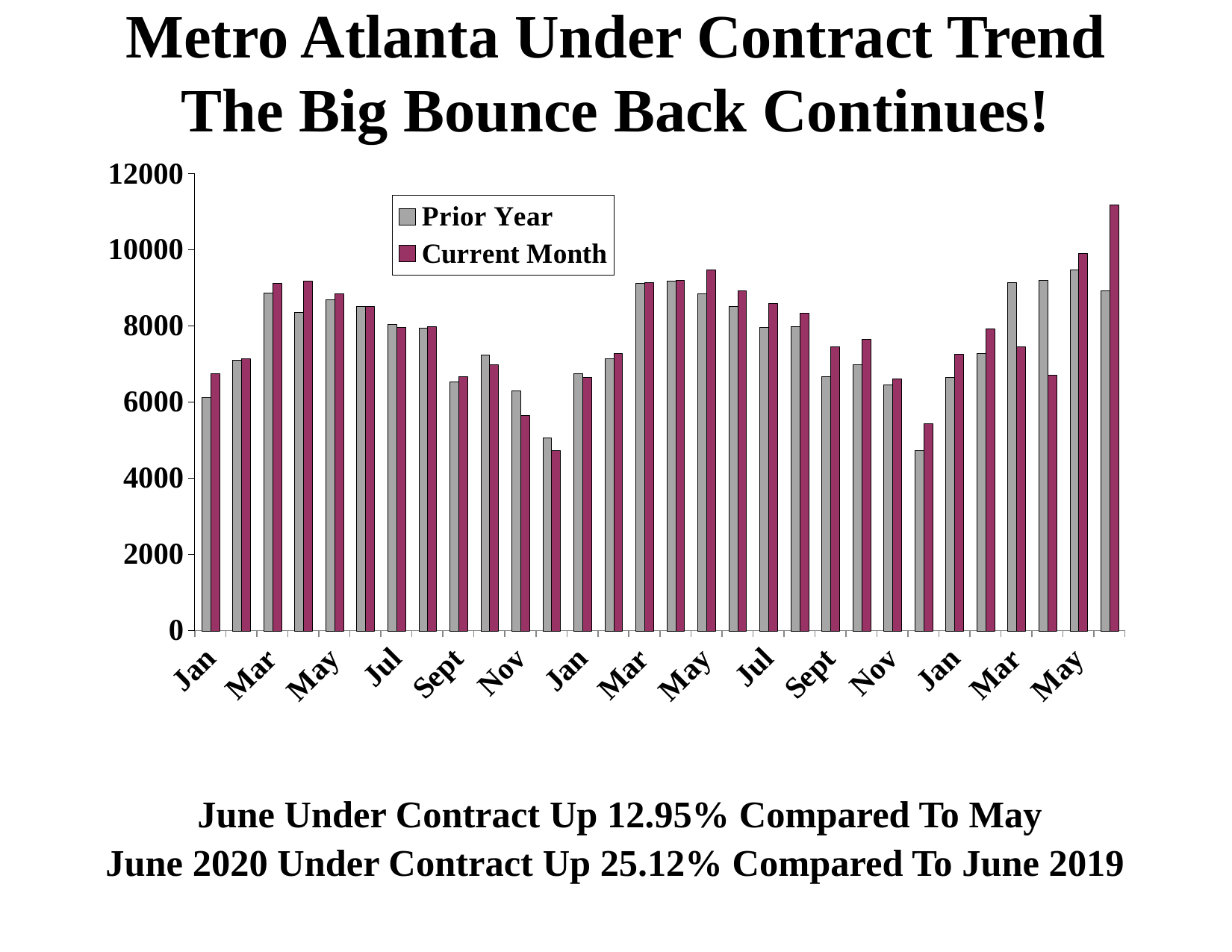
Which series is drawn in the dark magenta colour? Current Month Is the Current Month value for the first Mar on the chart greater or less than 8000? greater For the first Nov on the chart, which is larger: the Prior Year bar or the Current Month bar? Prior Year Which bar is the tallest on the chart? The Current Month bar for the last month (June 2020) Do the Current Month values rise or fall from the first Jan to the first Mar on the chart? rise What are the two series named in the legend? Prior Year and Current Month How many series does the legend list? 2 Is the Prior Year value for the first Jan on the chart greater or less than 8000? less For the last month on the chart, which is larger: the Prior Year bar or the Current Month bar? Current Month What kind of chart is shown on the slide? bar chart What is the highest value shown on the vertical axis? 12000 Is the Current Month value for the last month on the chart greater or less than 10000? greater